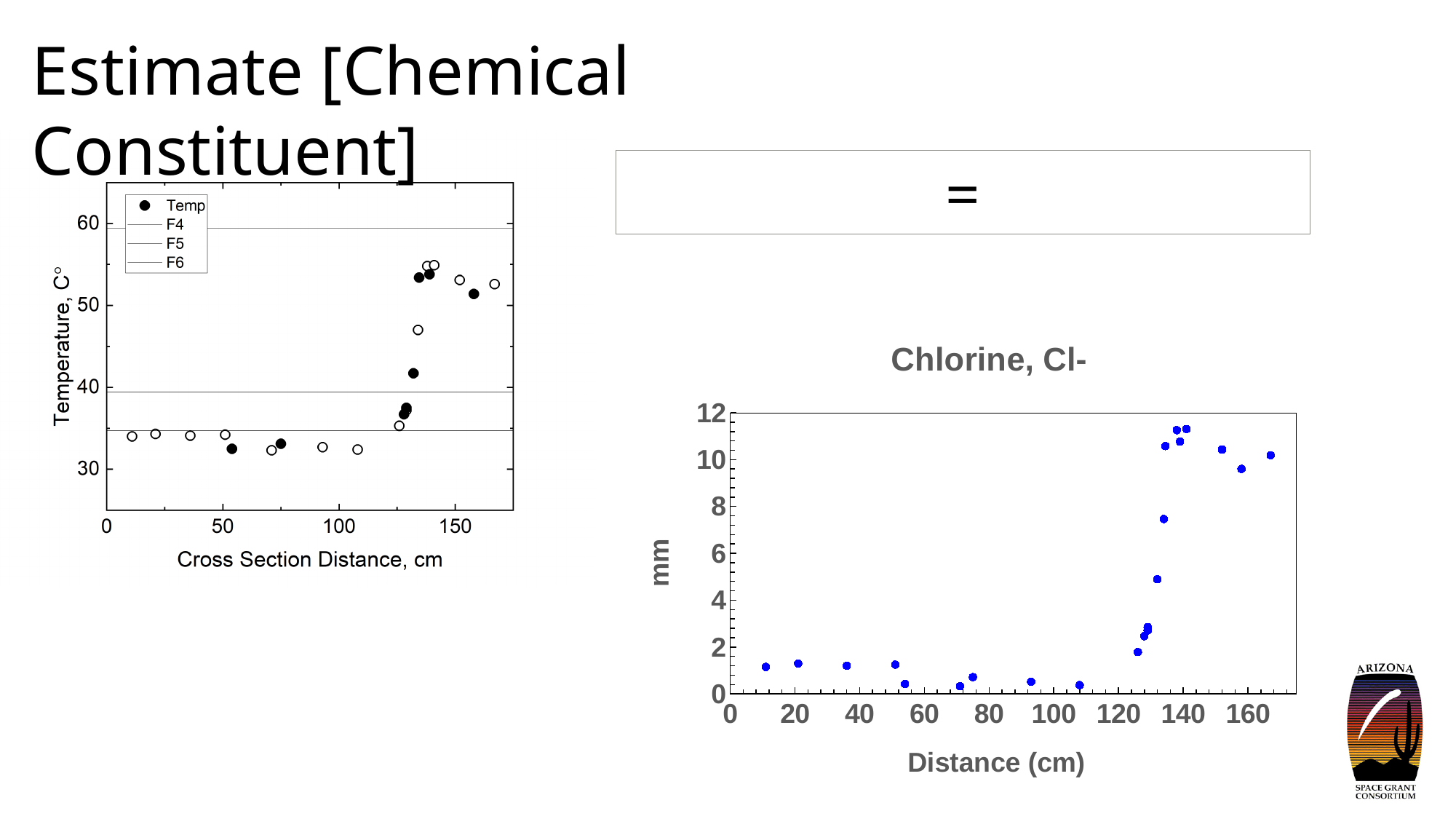
On the left chart, is the temperature at a cross section distance of about 140 cm greater or less than 50? greater On the Chlorine, Cl- chart, which is larger: the value at about 160 cm or the value at about 20 cm? the value at about 160 cm On the left chart, do the temperature values generally rise or fall as cross section distance increases? rise What kind of chart is the Chlorine, Cl- chart? scatter chart On the Chlorine, Cl- chart, is the value at a distance of about 20 cm greater or less than 2? less On the Chlorine, Cl- chart, is the value at a distance of about 140 cm greater or less than 10? greater How many series does the legend of the left chart list? 4 What is the x-axis label of the Chlorine, Cl- chart? Distance (cm) What kind of chart is the left chart (Temperature vs Cross Section Distance)? scatter chart On the Chlorine, Cl- chart, do the values generally rise or fall as distance increases? rise What is the title of the right chart? Chlorine, Cl-